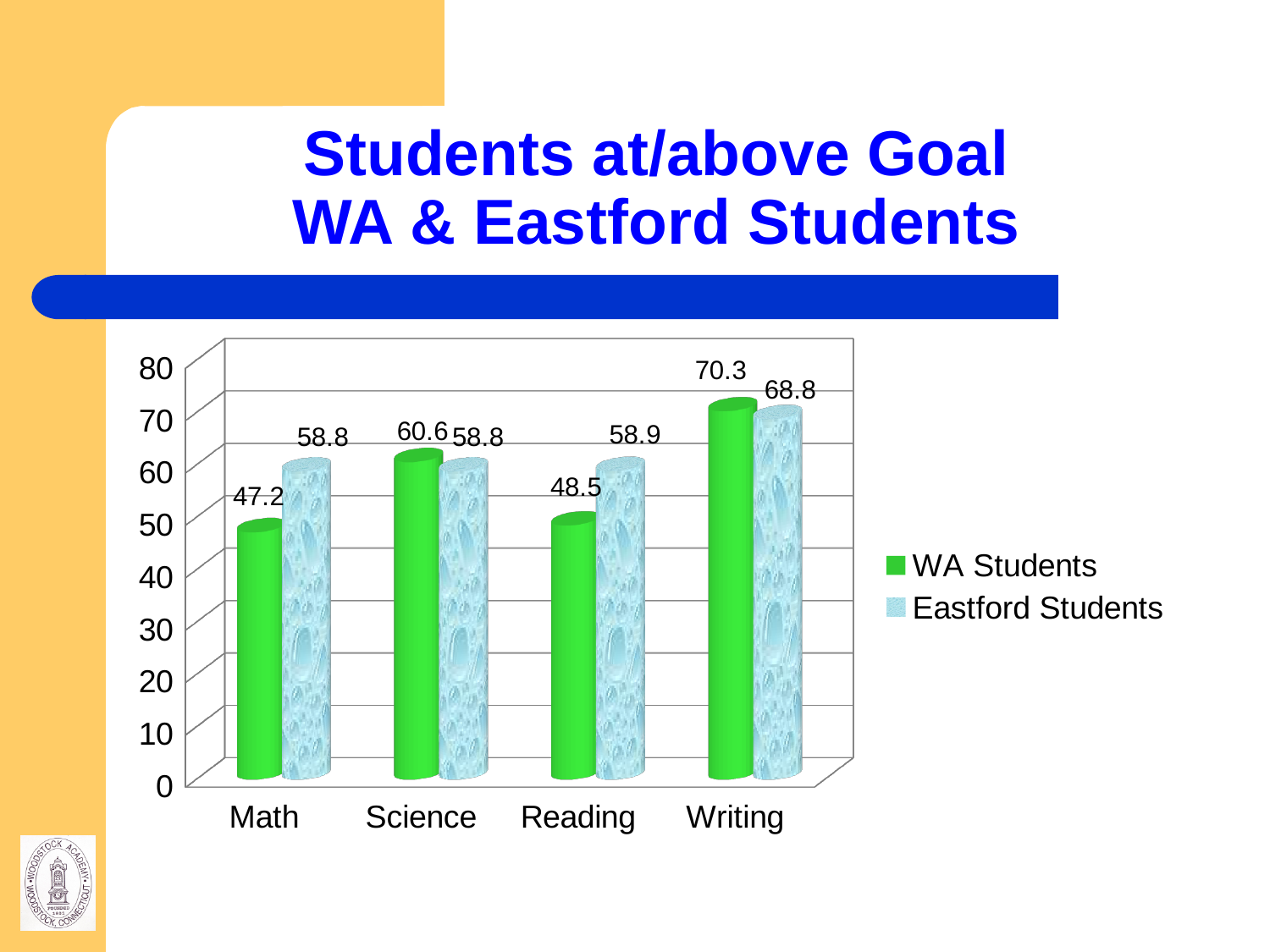
What is the difference between WA Students and Eastford Students in Writing? 1.5 Which category has the lowest value for WA Students? Math What is the difference between Eastford Students and WA Students in Math? 11.6 What is the value for Eastford Students in Reading? 58.9 What is the value for WA Students in Math? 47.2 What kind of chart is shown on the slide? Bar chart Is the value for WA Students in Science greater or less than 50? greater How many series does the legend list? 2 In Reading, which is larger: WA Students or Eastford Students? Eastford Students How many categories are shown on the x axis? 4 What is the value for WA Students in Writing? 70.3 Which category has the highest value for WA Students? Writing